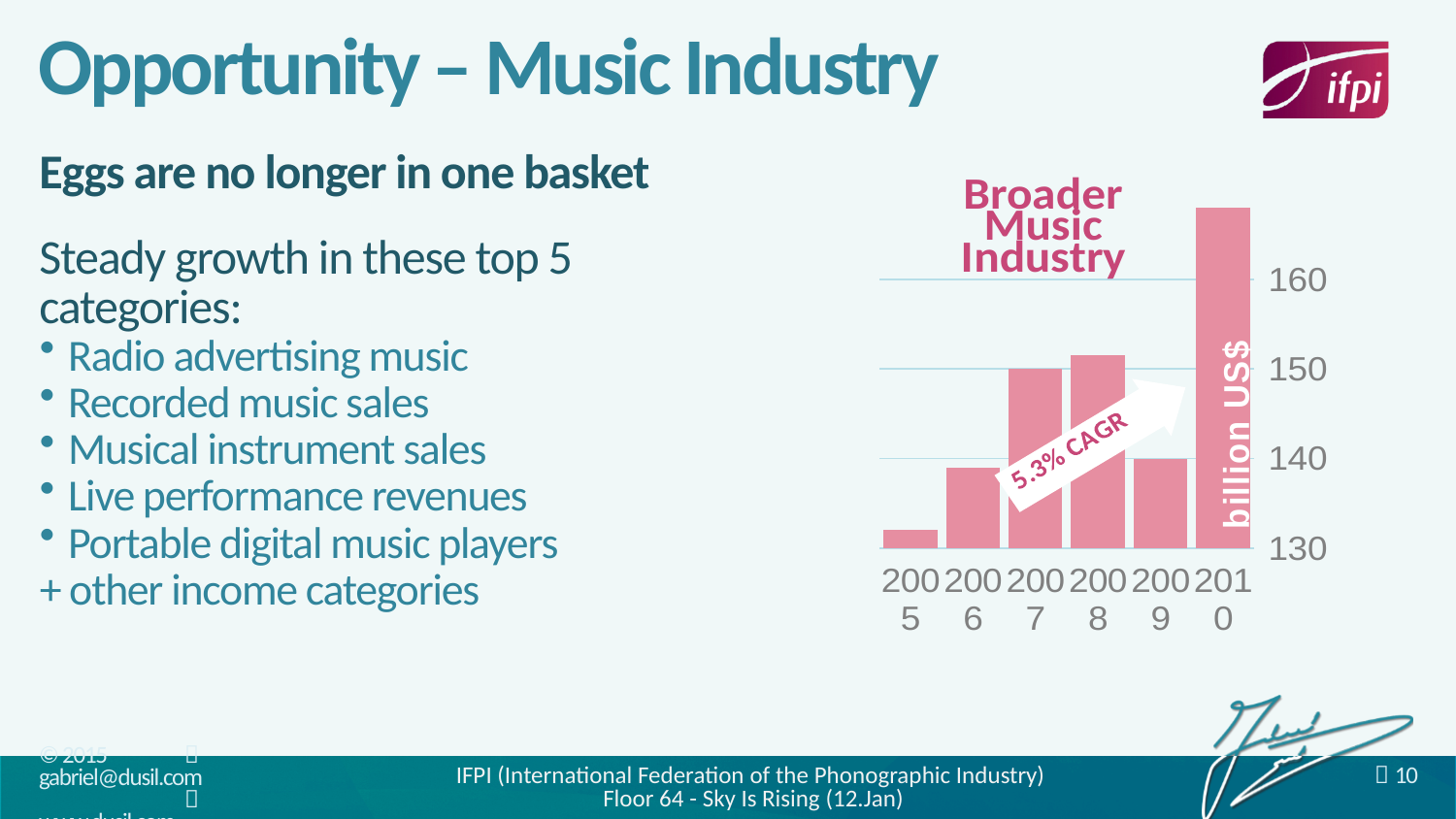
How many years are plotted on the chart? 6 What kind of chart is shown on the slide? bar chart Is the value for 2010 greater or less than 160? greater Is the value for 2005 greater or less than 140? less Which year has the larger value, 2009 or 2010? 2010 Which year has the highest value on the chart? 2010 What is the title of the chart? Broader Music Industry Which year has the larger value, 2006 or 2007? 2007 Which year has the lowest value on the chart? 2005 Is the value for 2009 greater or less than 150? less What growth rate is annotated on the arrow in the chart? 5.3% CAGR